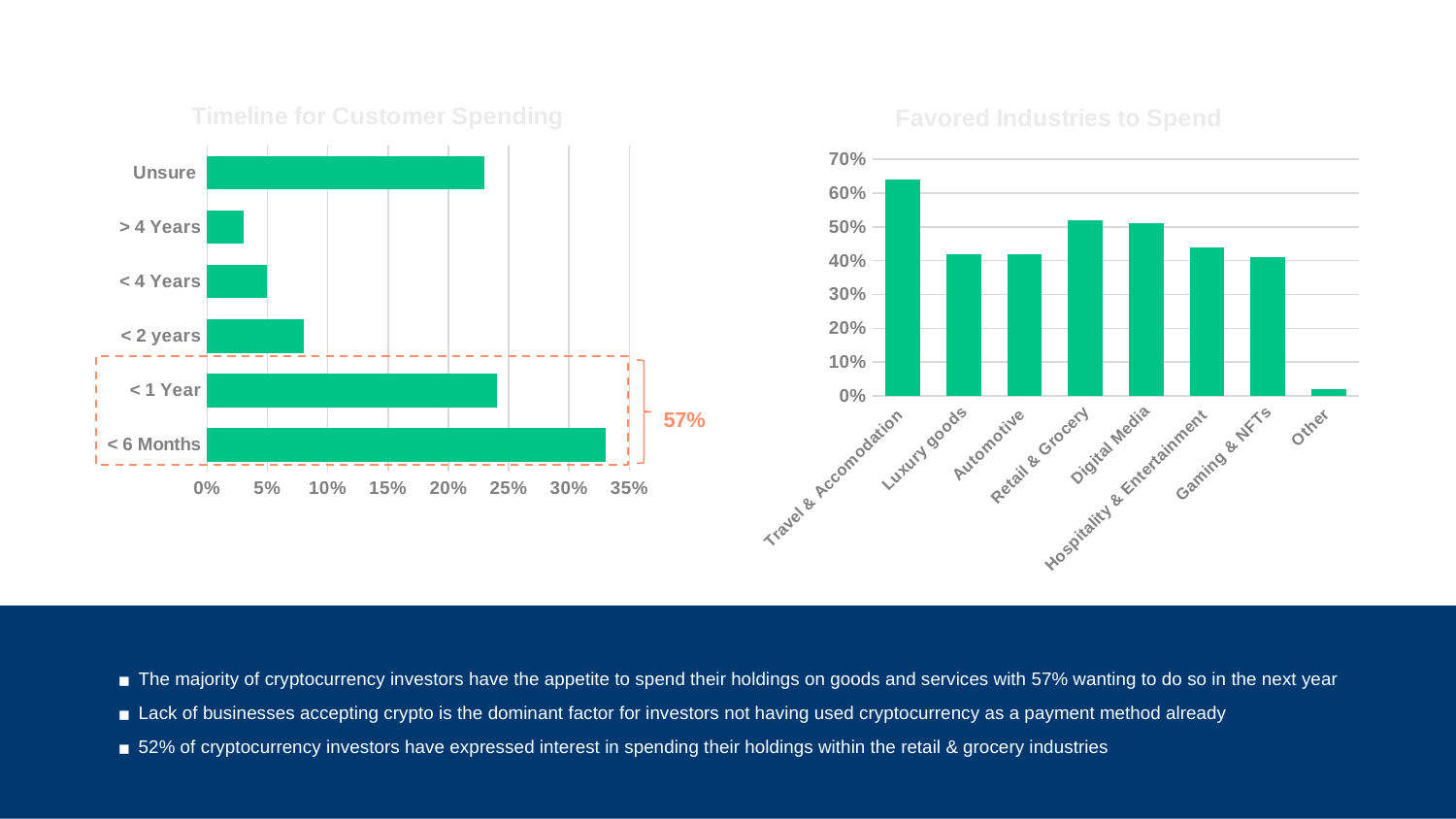
In the 'Timeline for Customer Spending' chart, which category has the highest value? < 6 Months In the 'Timeline for Customer Spending' chart, is the value for 'Unsure' greater or less than 20%? greater In the 'Timeline for Customer Spending' chart, is the value for '< 2 years' greater or less than 10%? less In the 'Timeline for Customer Spending' chart, what combined percentage is shown for the highlighted '< 1 Year' and '< 6 Months' bars? 57% What kind of chart is the 'Timeline for Customer Spending' chart? bar chart In the 'Favored Industries to Spend' chart, is the value for 'Travel & Accomodation' greater or less than 60%? greater In the 'Timeline for Customer Spending' chart, which category has the lowest value? > 4 Years In the 'Favored Industries to Spend' chart, which category has the lowest value? Other How many categories are shown in the 'Favored Industries to Spend' chart? 8 How many categories are shown in the 'Timeline for Customer Spending' chart? 6 In the 'Favored Industries to Spend' chart, which industry has the highest value? Travel & Accomodation In the 'Favored Industries to Spend' chart, which is larger: 'Retail & Grocery' or 'Luxury goods'? Retail & Grocery